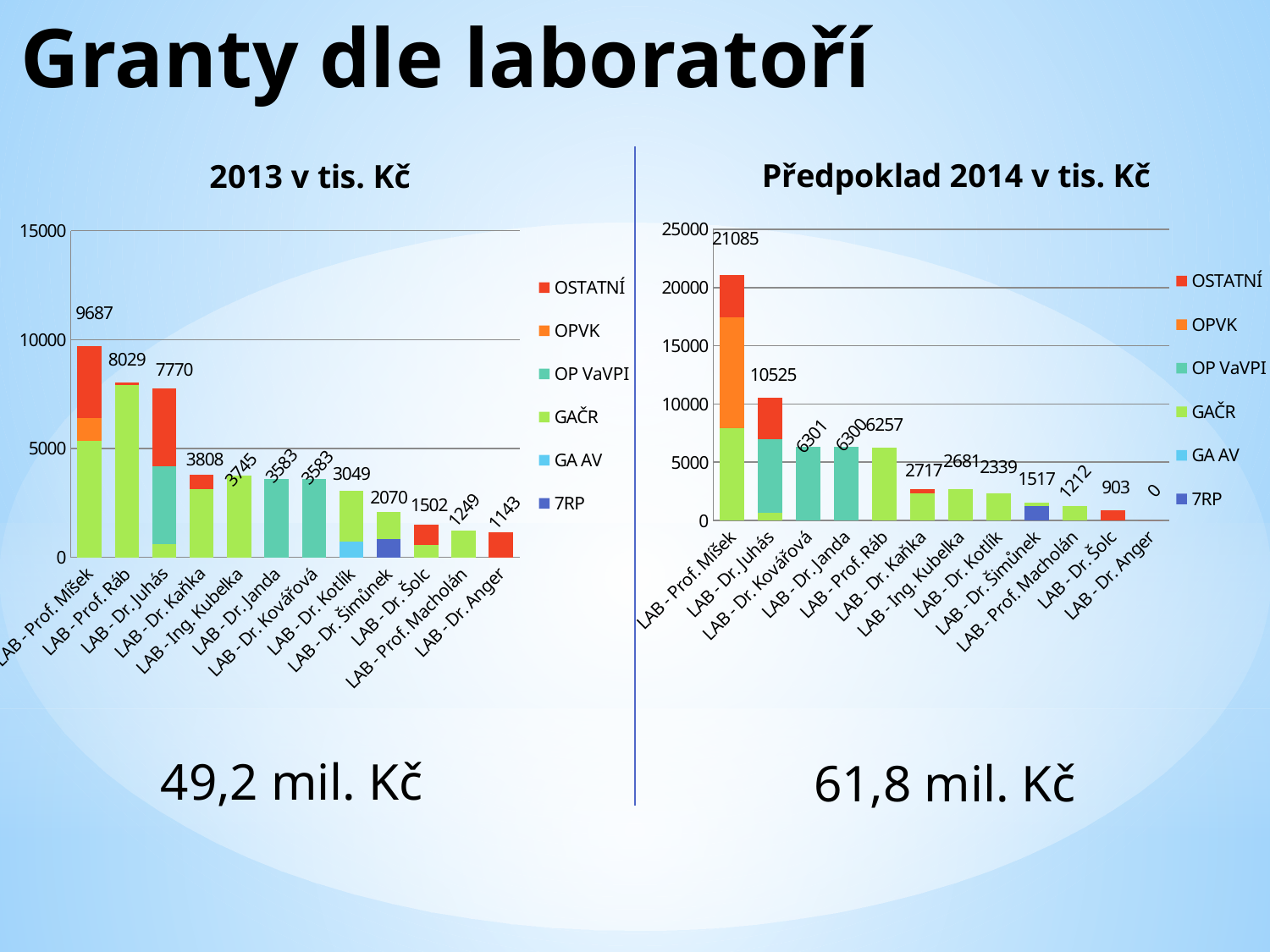
In the chart titled "Předpoklad 2014 v tis. Kč", which is larger: the total for LAB - Dr. Kaňka or LAB - Dr. Kotlík? LAB - Dr. Kaňka How many series does the legend of the chart titled "2013 v tis. Kč" list? 6 How many laboratories are shown on the x axis of the chart titled "Předpoklad 2014 v tis. Kč"? 12 In the chart titled "Předpoklad 2014 v tis. Kč", what is the total labelled for LAB - Dr. Anger? 0 In the chart titled "2013 v tis. Kč", do the totals rise or fall from left to right along the x axis? fall In the chart titled "2013 v tis. Kč", what is the difference between the totals for LAB - Prof. Míšek and LAB - Prof. Ráb? 1658 In the chart titled "2013 v tis. Kč", what is the total value labelled for LAB - Prof. Míšek? 9687 In the chart titled "2013 v tis. Kč", which laboratory has the lowest total? LAB - Dr. Anger In the chart titled "2013 v tis. Kč", is the total for LAB - Dr. Juhás greater or less than 5000? greater In the chart titled "Předpoklad 2014 v tis. Kč", what is the total value labelled for LAB - Dr. Juhás? 10525 What kind of chart is the chart titled "Předpoklad 2014 v tis. Kč"? stacked bar chart In the chart titled "Předpoklad 2014 v tis. Kč", which laboratory has the highest total? LAB - Prof. Míšek